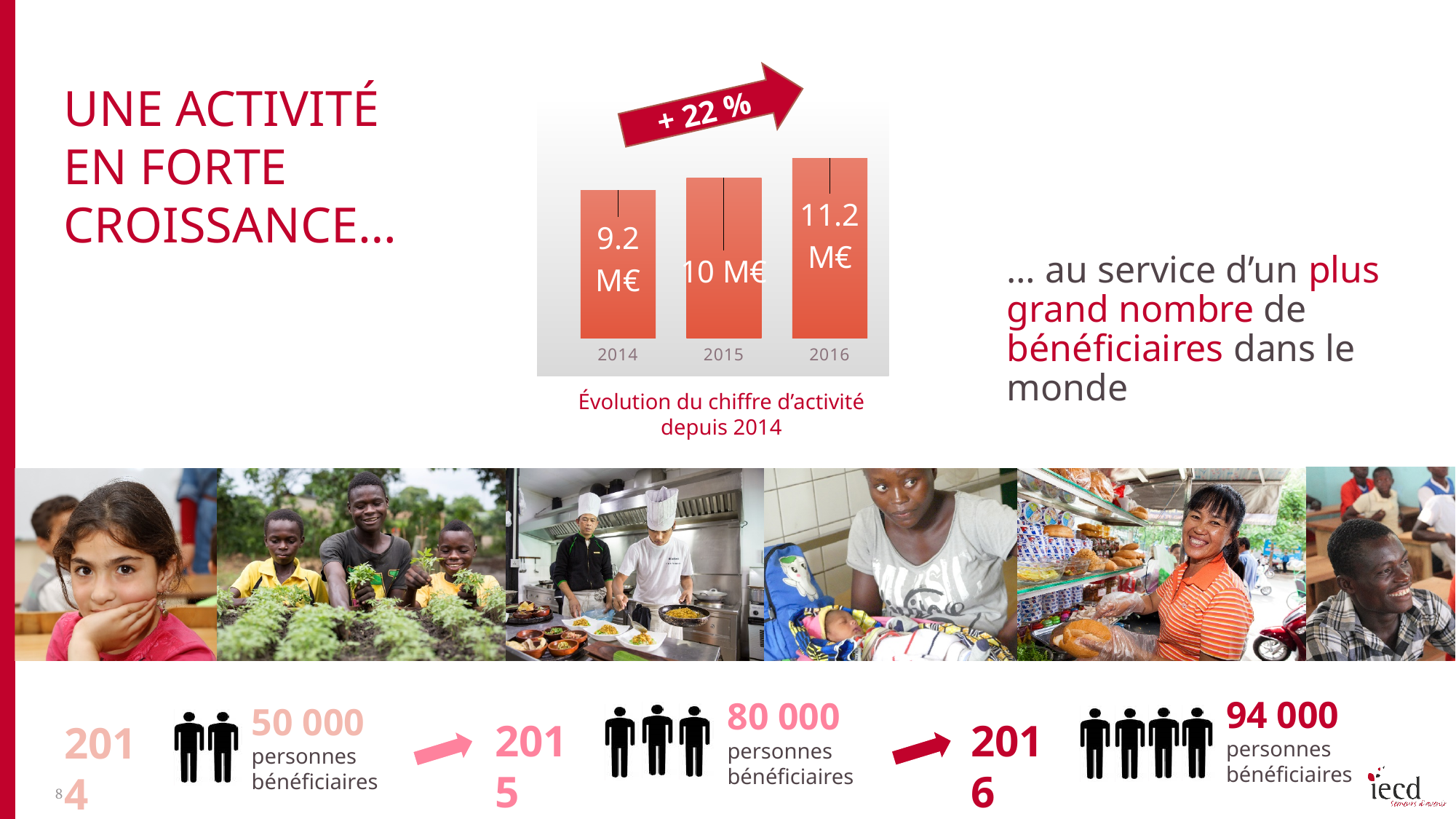
Which year has the highest value in the bar chart? 2016 What is the value shown for 2015 in the bar chart? 10 M€ What percentage growth is indicated by the arrow above the bar chart? + 22 % What is the value shown for 2016 in the bar chart? 11.2 M€ Which year has the lowest value in the bar chart? 2014 Which is larger in the bar chart, the value for 2015 or the value for 2016? 2016 What type of chart is shown on the slide? Bar chart Do the values in the bar chart rise or fall from 2014 to 2016? Rise How many bars are shown in the chart? 3 What is the difference between the 2016 and 2014 values in the bar chart? 2 M€ What is the value shown for 2014 in the bar chart? 9.2 M€ What is the difference between the 2015 and 2014 values in the bar chart? 0.8 M€